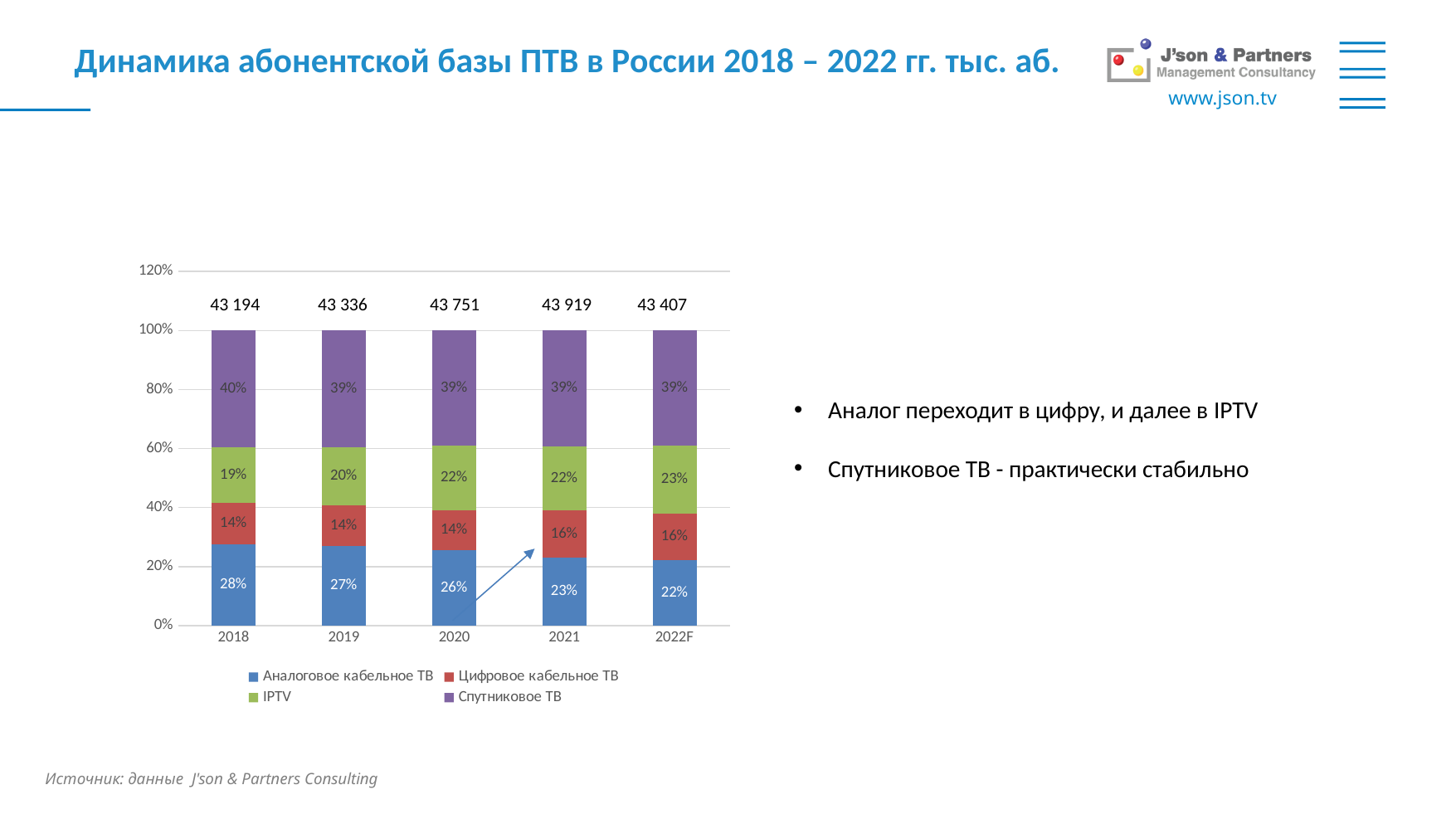
What is the share of IPTV in 2022F? 23% What is the share of Аналоговое кабельное ТВ in 2018? 28% What is the share of Цифровое кабельное ТВ in 2021? 16% Does the share of Аналоговое кабельное ТВ rise or fall from 2018 to 2022F? Fall What kind of chart is shown on the slide? Stacked bar chart What is the difference between the share of Спутниковое ТВ and IPTV in 2019? 19% In which year is the share of Аналоговое кабельное ТВ the lowest? 2022F How many series does the legend list? 4 Which series is shown in purple in the legend? Спутниковое ТВ How many years (categories) are shown on the x axis? 5 In which year is the total printed above the bars the highest? 2021 What total subscriber base (thousand) is printed above the 2020 bar? 43 751